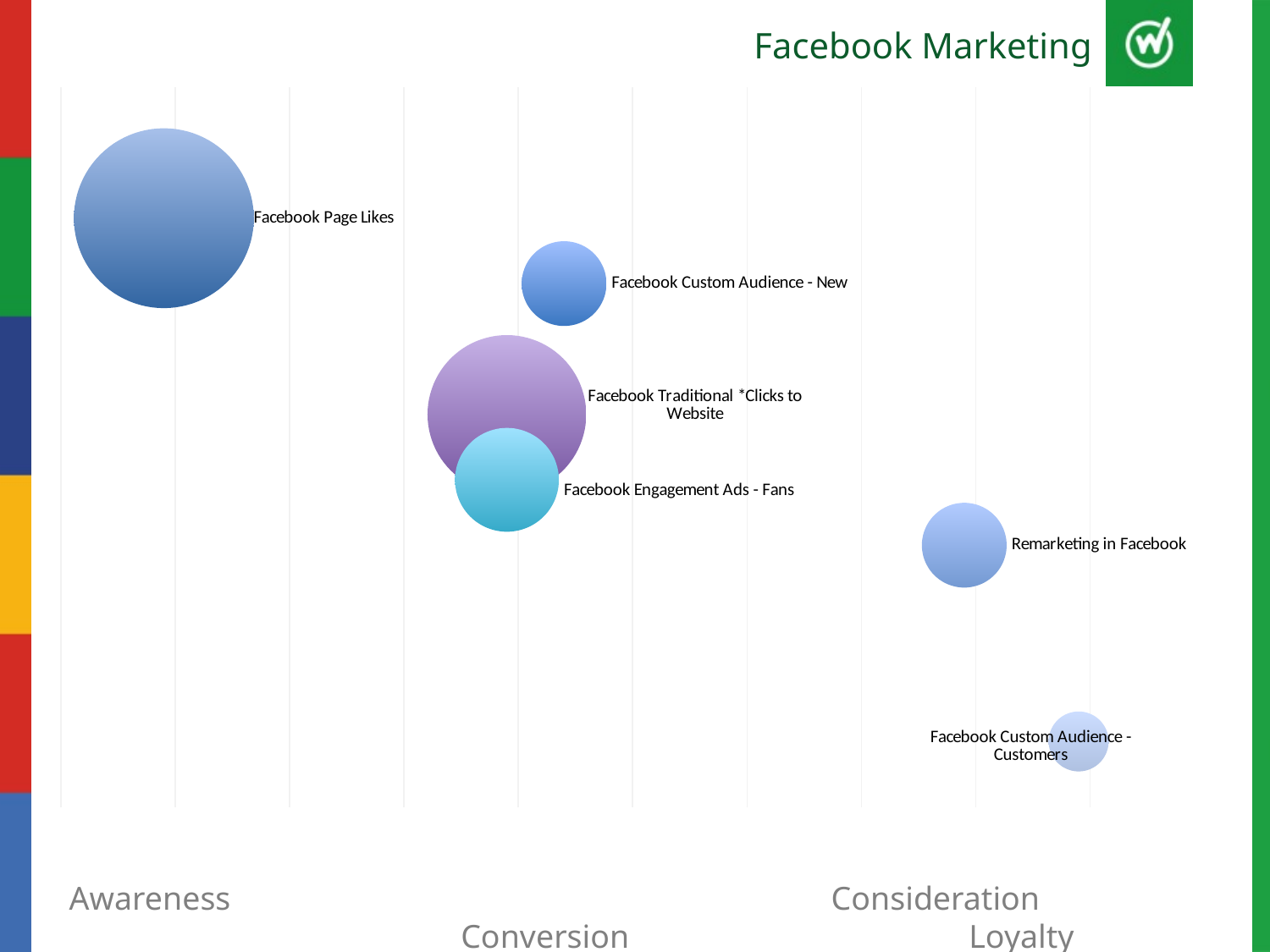
Which bubble is furthest to the left on the chart? Facebook Page Likes What colour is the Facebook Traditional *Clicks to Website bubble? Purple Which bubble is positioned highest on the chart? Facebook Page Likes What is the title of the chart? Facebook Marketing How many bubbles are plotted on the chart? 6 Which bubble is the smallest on the chart? Facebook Custom Audience - Customers Which bubble is the largest on the chart? Facebook Page Likes Which bubble is positioned lowest on the chart? Facebook Custom Audience - Customers Which bubble is positioned higher on the chart, Facebook Custom Audience - New or Remarketing in Facebook? Facebook Custom Audience - New Which bubble is larger, Facebook Traditional *Clicks to Website or Facebook Engagement Ads - Fans? Facebook Traditional *Clicks to Website Which bubble is larger, Facebook Page Likes or Remarketing in Facebook? Facebook Page Likes What kind of chart is shown on the slide? Bubble chart